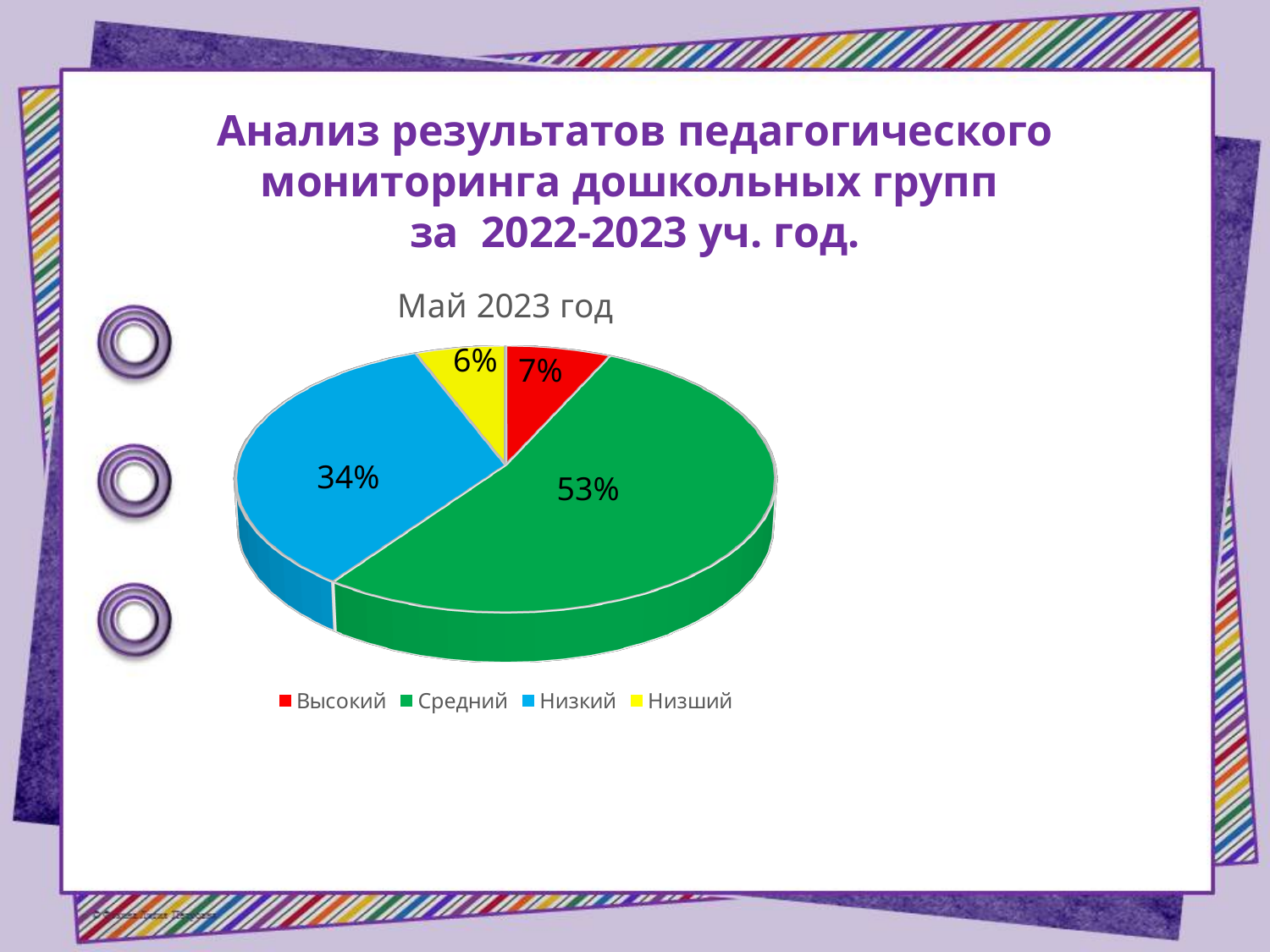
What is the difference between the shares of Средний and Низкий? 19% How many categories does the legend list? 4 What is the title of the chart? Май 2023 год What percentage is shown for Низший? 6% Which category has the smallest share of the pie? Низший What percentage is shown for Высокий? 7% Which category has the largest share of the pie? Средний What percentage is shown for Средний? 53% What colour is the slice for Низкий? blue Which is larger, the share for Высокий or the share for Низкий? Низкий What type of chart is shown on the slide? pie chart What percentage is shown for Низкий? 34%